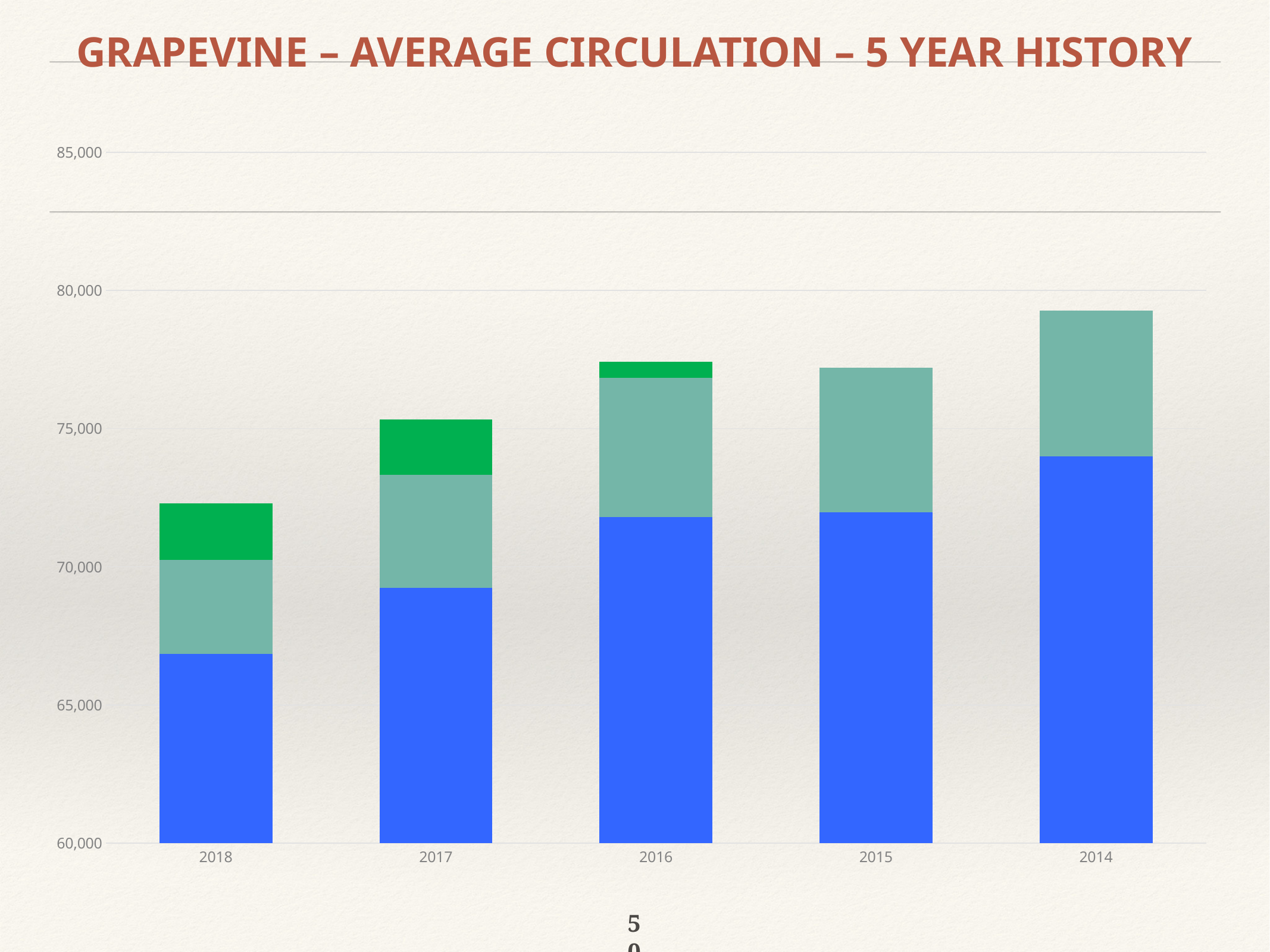
Is the blue segment for 2014 greater or less than 75,000? less How many years are shown on the x axis of the chart? 5 What is the title of the slide? GRAPEVINE – AVERAGE CIRCULATION – 5 YEAR HISTORY Which year has the tallest stacked bar? 2014 Which year has the shortest stacked bar? 2018 What kind of chart is shown on the slide? bar chart Is the blue segment for 2018 greater or less than 70,000? less Is the total bar height for 2016 greater or less than 75,000? greater Which year has a taller stacked bar, 2014 or 2018? 2014 Moving left to right along the x axis from 2018 to 2014, do the total bar heights generally rise or fall? rise